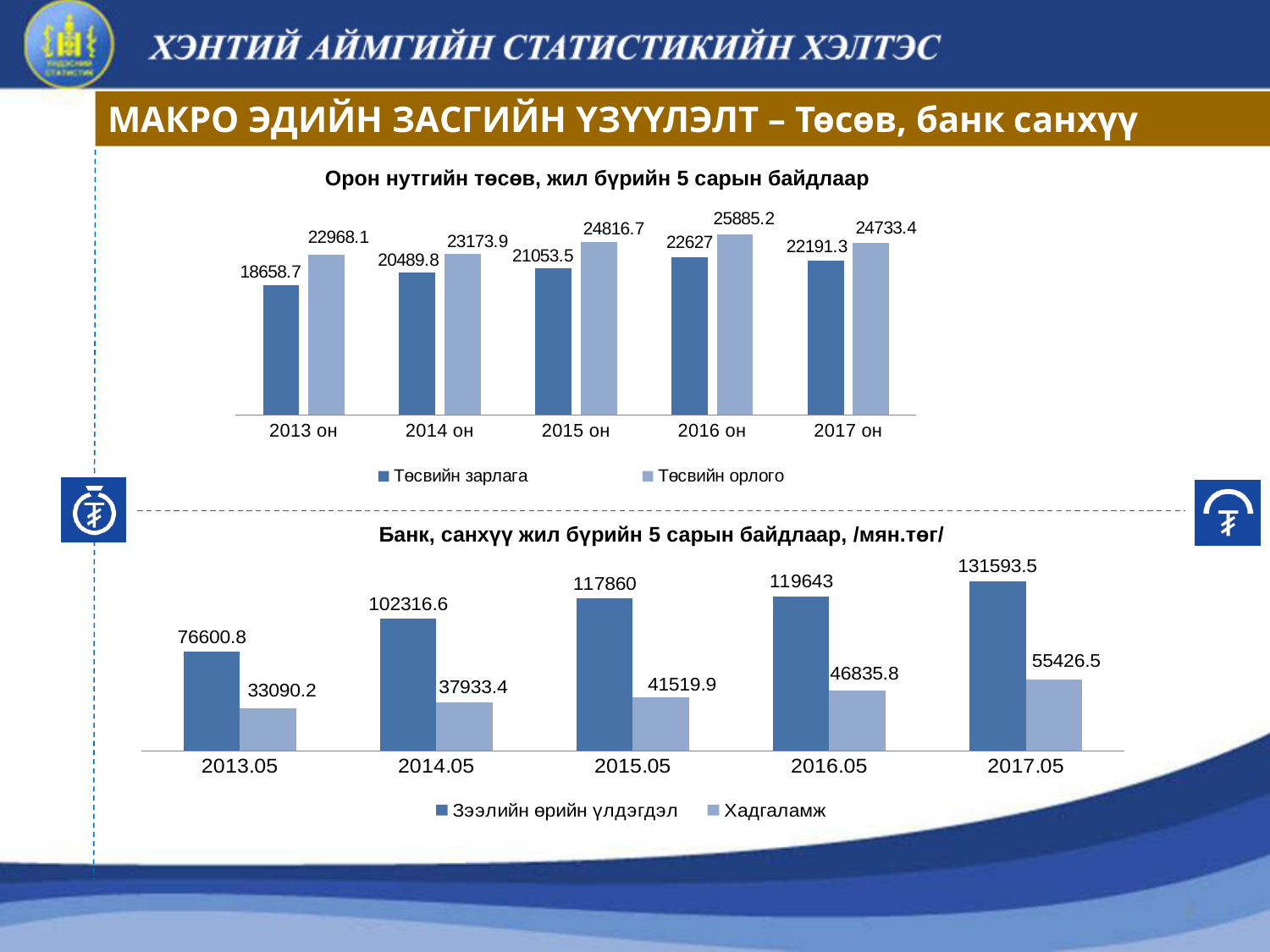
In the bottom chart (Банк, санхүү), what is the value of Хадгаламж for 2014.05? 37933.4 In the bottom chart (Банк, санхүү), what is the difference between Зээлийн өрийн үлдэгдэл and Хадгаламж for 2016.05? 72807.2 What type of chart is the bottom chart (Банк, санхүү)? bar chart In the top chart (Орон нутгийн төсөв), what is the value of Төсвийн орлого for 2016 он? 25885.2 In the top chart (Орон нутгийн төсөв), does Төсвийн зарлага rise or fall from 2013 он to 2016 он? rise In the top chart (Орон нутгийн төсөв), what is the value of Төсвийн зарлага for 2013 он? 18658.7 In the bottom chart (Банк, санхүү), how many periods are shown on the x axis? 5 In the top chart (Орон нутгийн төсөв), which year has the highest Төсвийн орлого value? 2016 он In the bottom chart (Банк, санхүү), which period has the lowest Зээлийн өрийн үлдэгдэл value? 2013.05 In the top chart (Орон нутгийн төсөв), what is the difference between Төсвийн орлого and Төсвийн зарлага for 2015 он? 3763.2 In the bottom chart (Банк, санхүү), what is the value of Зээлийн өрийн үлдэгдэл for 2017.05? 131593.5 In the top chart (Орон нутгийн төсөв), how many series does the legend list? 2